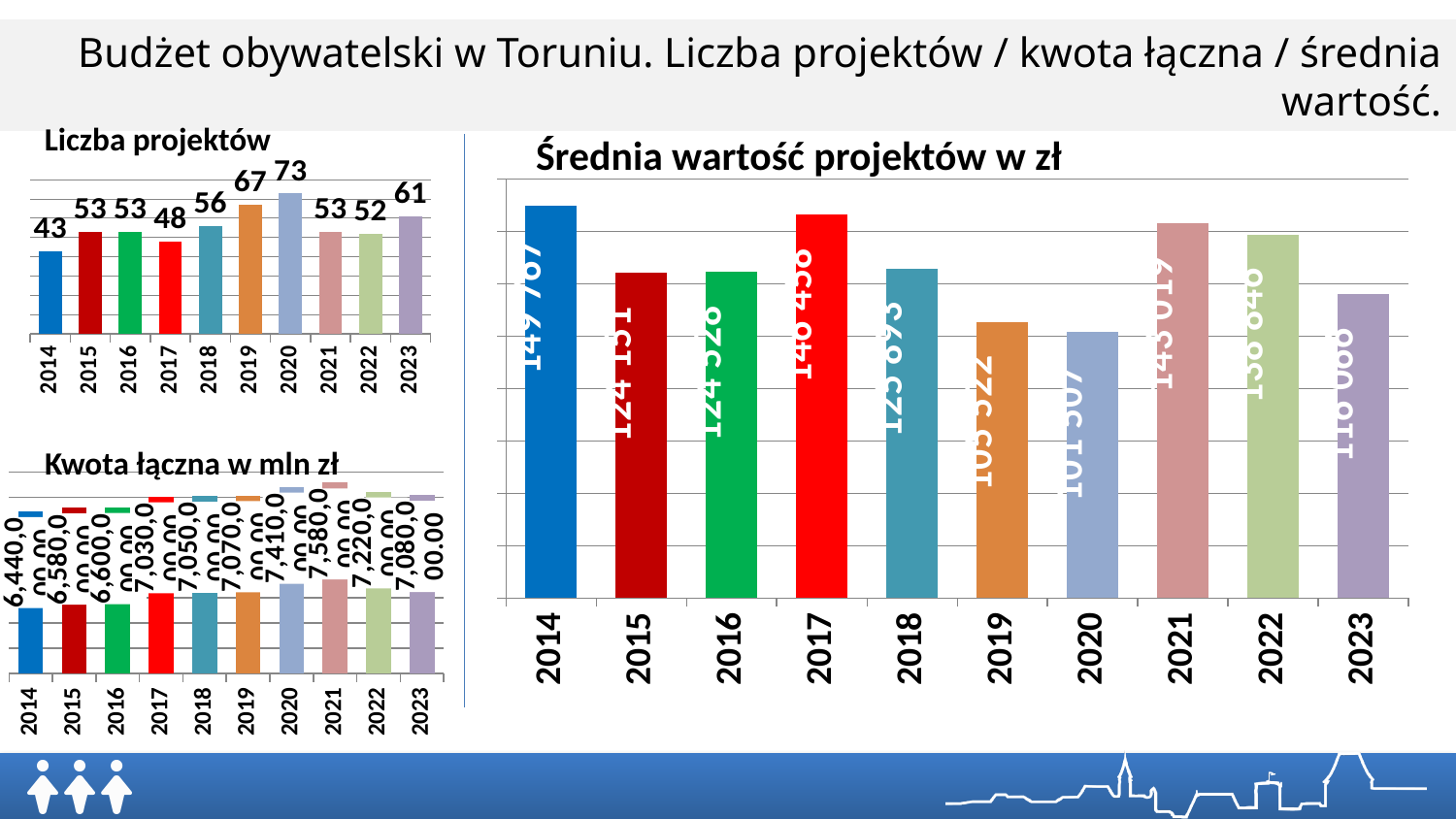
In the 'Liczba projektów' chart, how many years are shown on the x axis? 10 In the 'Średnia wartość projektów w zł' chart, which year has the tallest bar? 2014 In the 'Liczba projektów' chart, which year has the lowest value? 2014 In the 'Liczba projektów' chart, what is the value for 2014? 43 In the 'Liczba projektów' chart, what is the value for 2023? 61 In the 'Liczba projektów' chart, which is larger, the value for 2019 or for 2023? 2019 In the 'Liczba projektów' chart, what is the value for 2020? 73 In the 'Liczba projektów' chart, what is the difference between the values for 2020 and 2014? 30 In the 'Średnia wartość projektów w zł' chart, which is larger, the value for 2017 or for 2018? 2017 In the 'Liczba projektów' chart, which year has the highest value? 2020 In the 'Średnia wartość projektów w zł' chart, which year has the shortest bar? 2020 What kind of chart is 'Średnia wartość projektów w zł'? bar chart